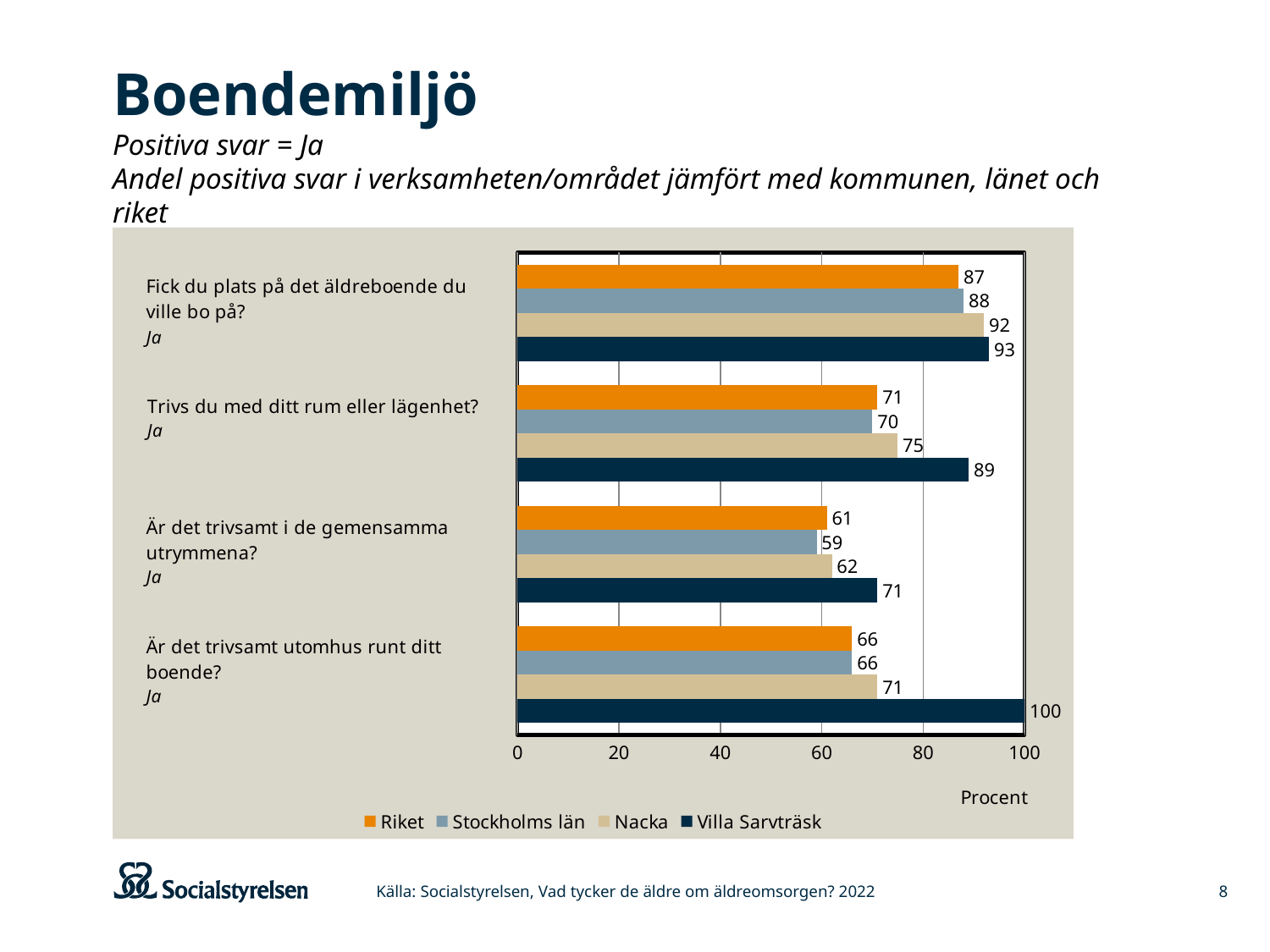
Which is larger on "Fick du plats på det äldreboende du ville bo på?": Nacka or Stockholms län? Nacka What is the value for Nacka on "Trivs du med ditt rum eller lägenhet?"? 75 Which series has the lowest value on "Är det trivsamt i de gemensamma utrymmena?"? Stockholms län What unit is shown on the horizontal axis of the chart? Procent Which series has the highest value on "Trivs du med ditt rum eller lägenhet?"? Villa Sarvträsk What is the value for Villa Sarvträsk on "Är det trivsamt utomhus runt ditt boende?"? 100 How many question categories are shown in the chart? 4 What is the value for Riket on "Fick du plats på det äldreboende du ville bo på?"? 87 What kind of chart is shown on the slide? Bar chart What is the value for Stockholms län on "Är det trivsamt i de gemensamma utrymmena?"? 59 How many series does the legend list? 4 What is the difference between Villa Sarvträsk and Riket on "Trivs du med ditt rum eller lägenhet?"? 18